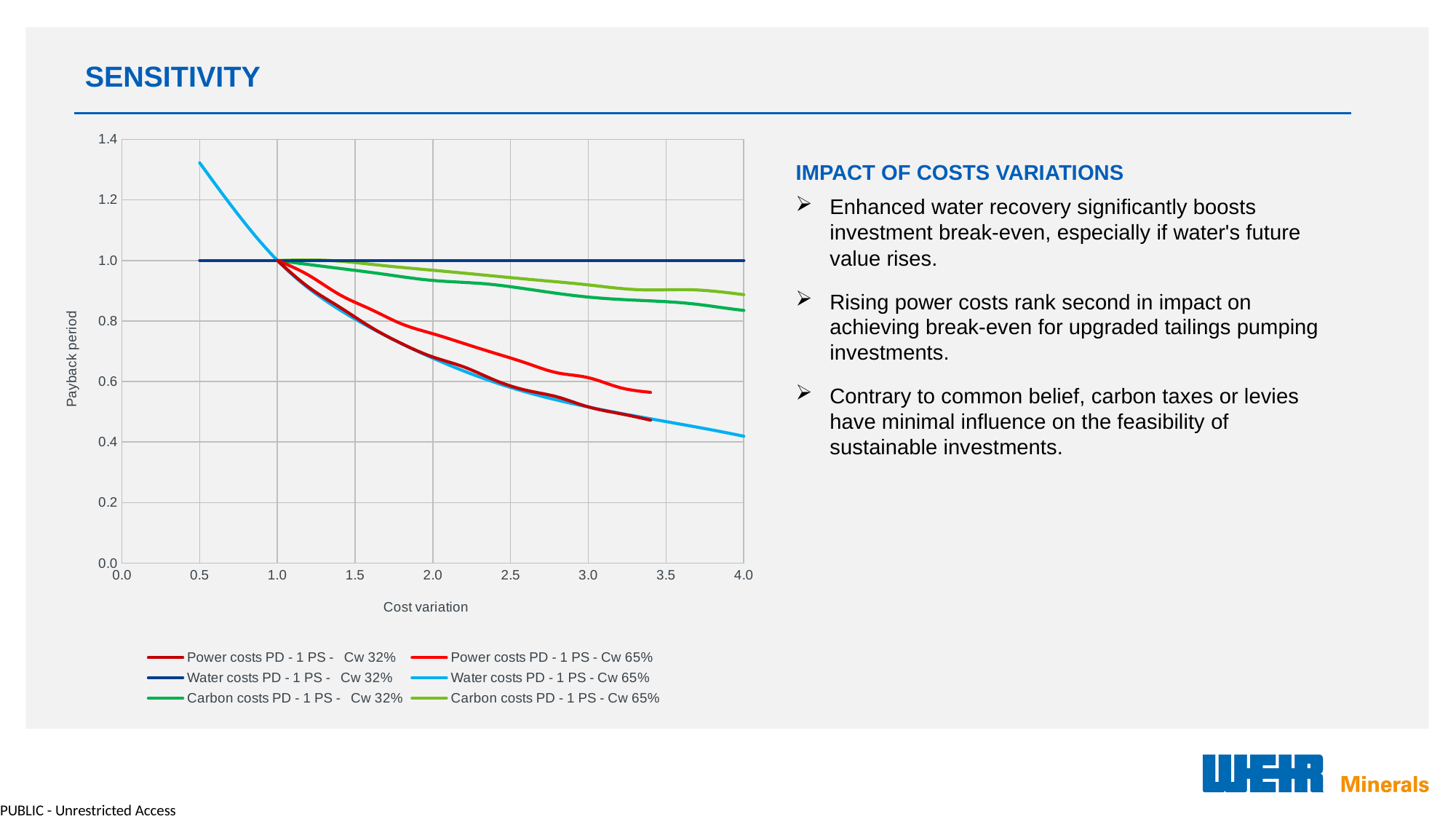
At a cost variation of 3.0, which has the larger payback period: Power costs PD - 1 PS - Cw 65% or Power costs PD - 1 PS - Cw 32%? Power costs PD - 1 PS - Cw 65% Is the payback period for Carbon costs PD - 1 PS - Cw 65% at a cost variation of 4.0 greater or less than 1.0? less What is the payback period for Power costs PD - 1 PS - Cw 65% at a cost variation of 1.0? 1.0 What is the payback period for Water costs PD - 1 PS - Cw 32% at a cost variation of 2.0? 1.0 How many series does the chart legend list? 6 Does the payback period for Water costs PD - 1 PS - Cw 65% rise or fall as cost variation increases? fall What is the title of the chart's y axis? Payback period Is the payback period for Water costs PD - 1 PS - Cw 65% at a cost variation of 4.0 greater or less than 0.6? less What kind of chart is shown on the slide? line chart Which series has the lowest payback period at a cost variation of 4.0? Water costs PD - 1 PS - Cw 65% Is the payback period for Water costs PD - 1 PS - Cw 65% at a cost variation of 0.5 greater or less than 1.2? greater What is the title of the chart's x axis? Cost variation